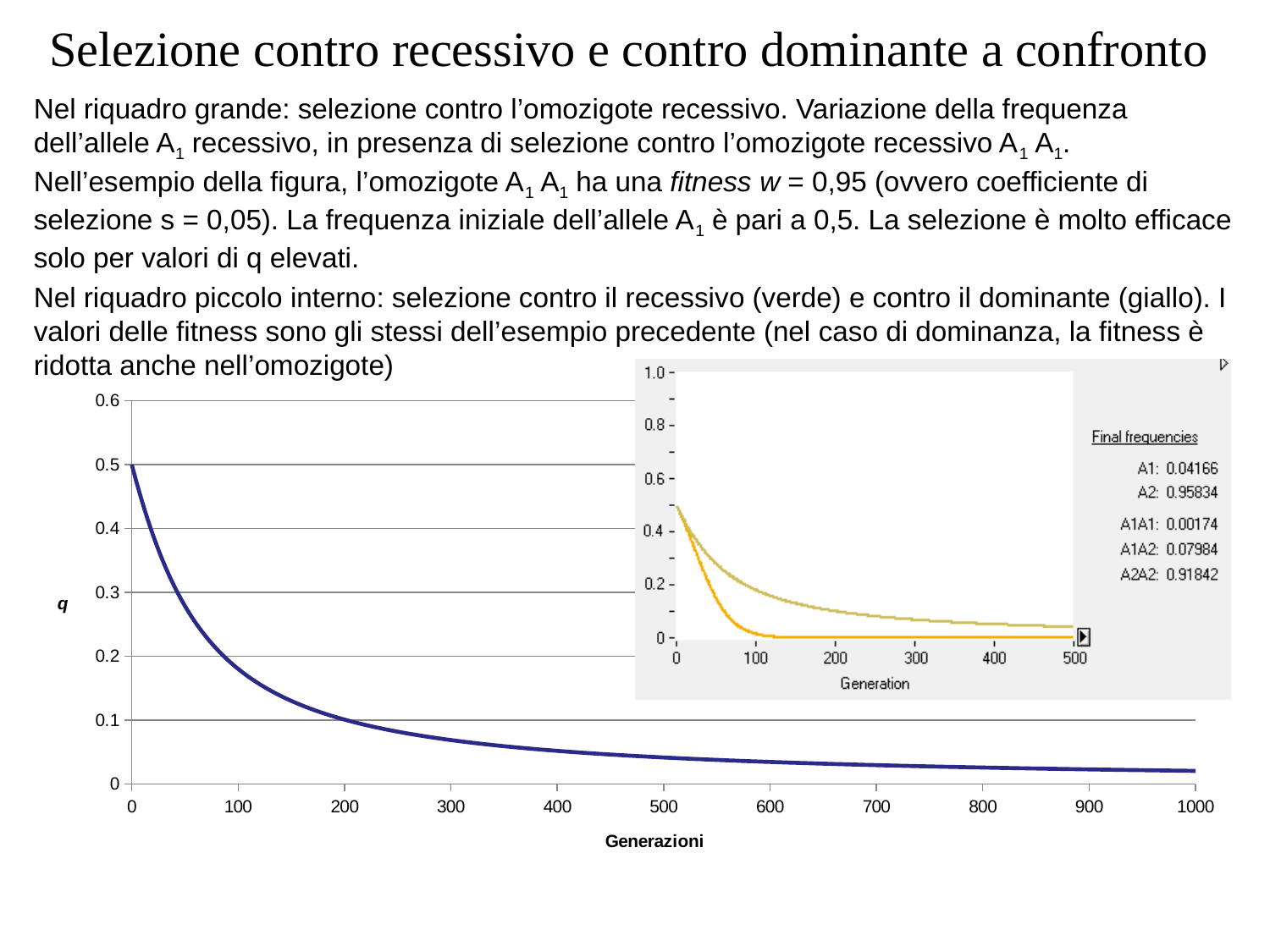
What is the label of the x axis of the large chart? Generazioni In the small inset chart, what is the final frequency listed for A2A2? 0.91842 In the small inset chart, which curve reaches zero first, the yellow one or the green one? the yellow one In the large chart, what is the value of q at generation 0? 0.5 In the large chart, is the value of q at generation 1000 greater or less than 0.1? less In the large chart, is the value of q at generation 500 greater or less than 0.1? less In the small inset chart, is the value of the green curve at generation 500 greater or less than 0.2? less What kind of chart is the large chart at the bottom of the slide? line chart In the large chart, does the value of q rise or fall as the number of generations increases? fall What is the highest tick value shown on the x axis of the large chart? 1000 In the small inset chart, what is the final frequency listed for A1? 0.04166